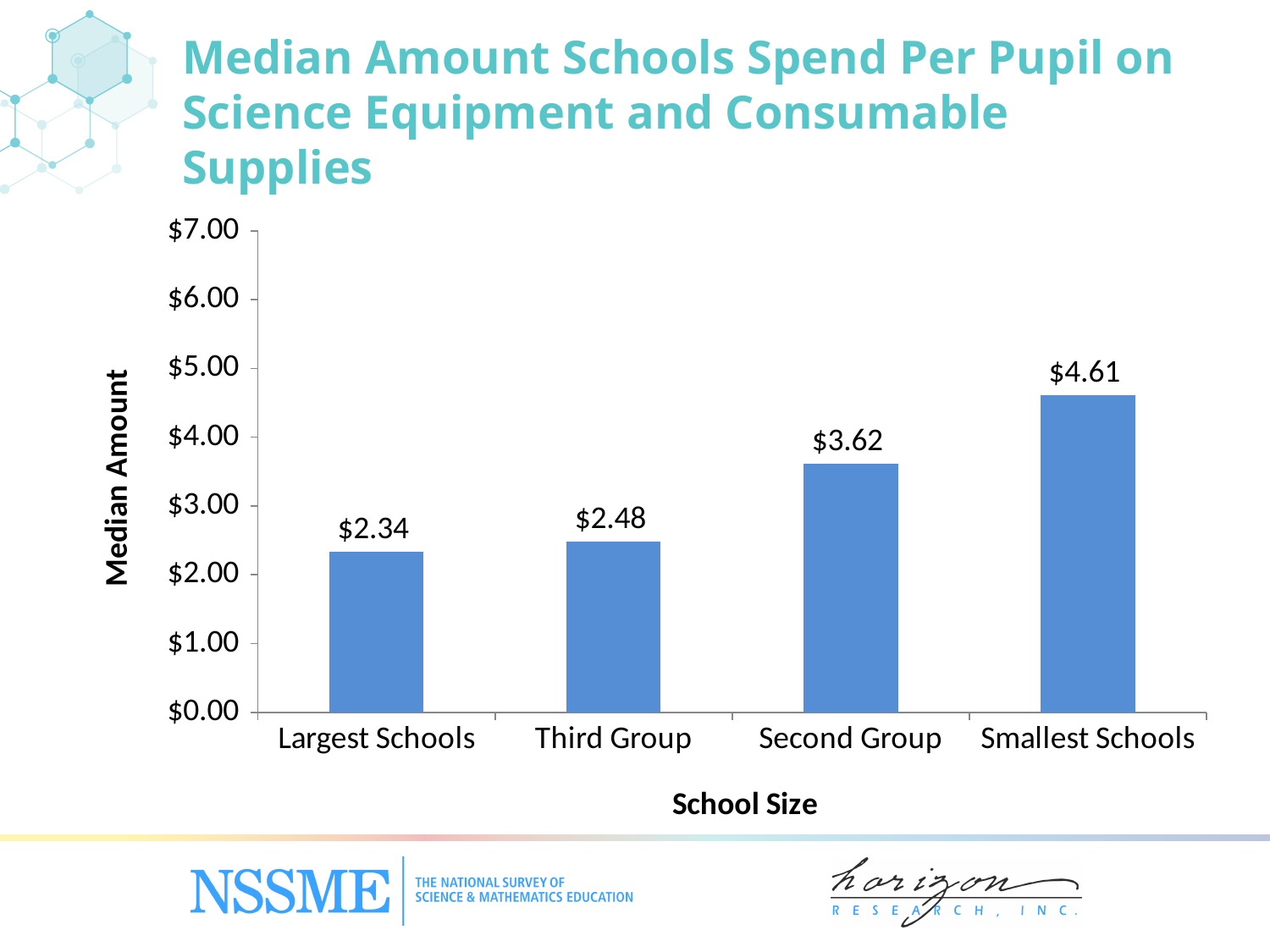
What is the difference between the median amounts for Smallest Schools and Largest Schools? $2.27 Which school size group has the lowest median amount spent per pupil? Largest Schools What kind of chart is shown on the slide? Bar chart Is the median amount for the Second Group greater or less than $3.00? greater What is the median amount spent per pupil for Smallest Schools? $4.61 Which school size group has the highest median amount spent per pupil? Smallest Schools Do the median amounts rise or fall moving from Largest Schools to Smallest Schools along the x axis? Rise What is the difference between the median amounts for the Second Group and the Third Group? $1.14 What is the median amount spent per pupil for the Second Group? $3.62 What is the median amount spent per pupil for Largest Schools? $2.34 Which has a larger median amount, the Third Group or the Second Group? Second Group How many school size groups are shown on the chart? 4